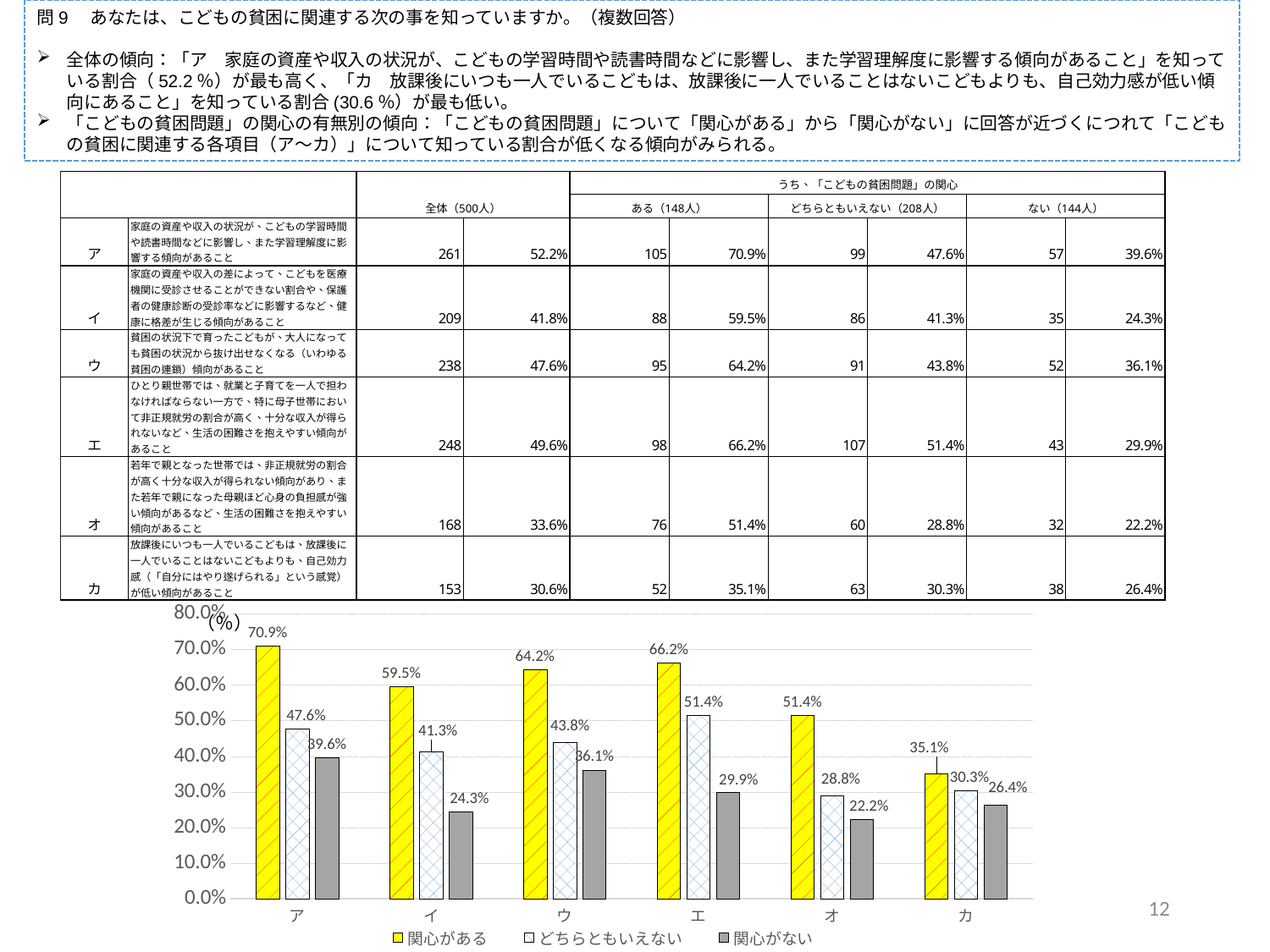
What is the value for どちらともいえない in category エ? 51.4% How many series does the chart legend list? 3 Which series is shown with yellow bars in the chart? 関心がある Which category has the highest value for 関心がある? ア What is the value for 関心がない in category イ? 24.3% What is the difference between 関心がある and 関心がない in category ア? 31.3% How many categories are shown on the x axis of the chart? 6 Which is larger in category カ: 関心がある or どちらともいえない? 関心がある Which category has the lowest value for 関心がない? オ Is the value for 関心がある in category オ greater or less than 60.0%? less What type of chart is shown on the slide? bar chart What is the value for 関心がある in category ア? 70.9%